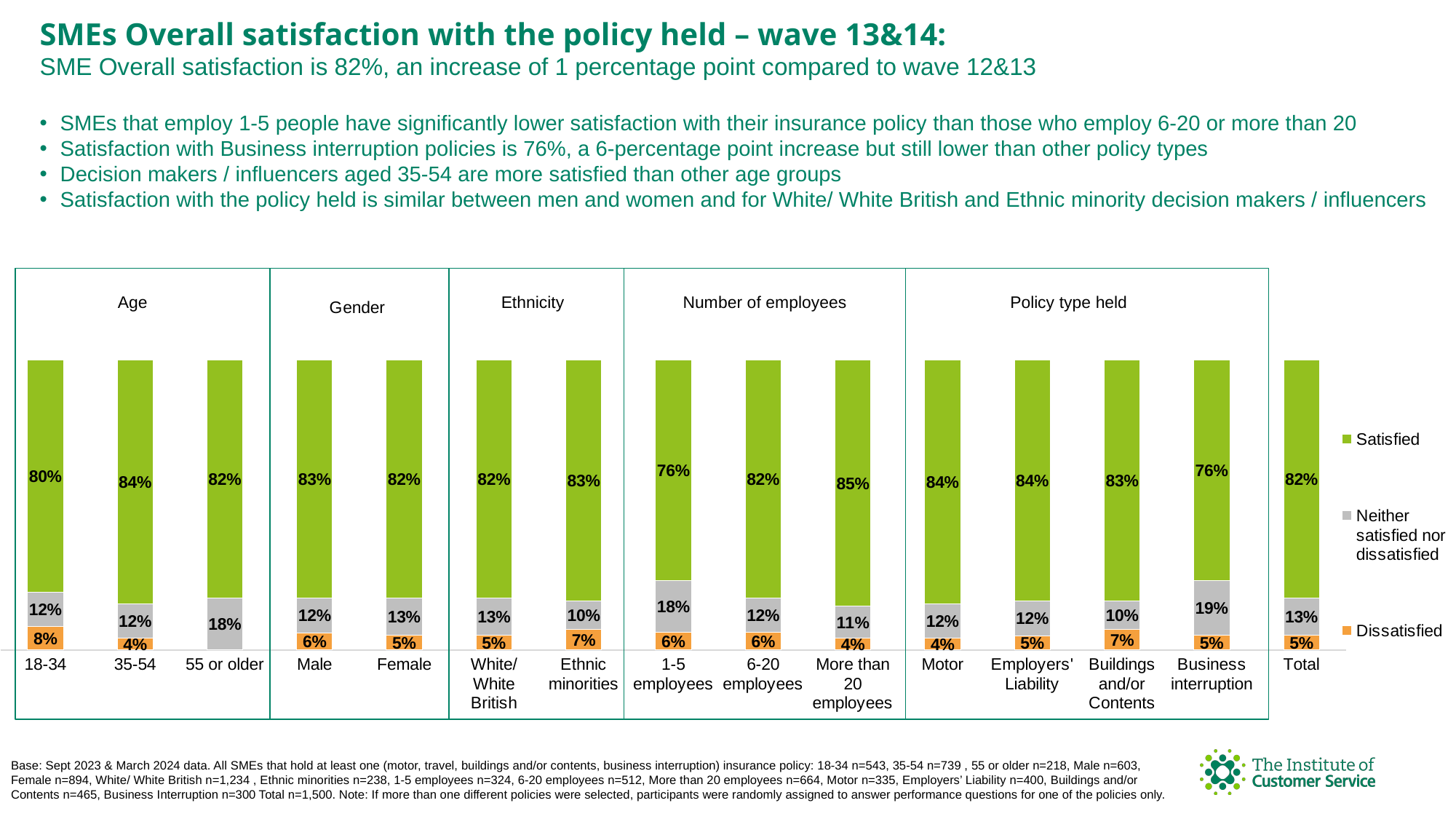
Which category has the highest Dissatisfied value? 18-34 What is the Dissatisfied value for Buildings and/or Contents? 7% What is the Dissatisfied value for the 18-34 age group? 8% Which category has the highest Satisfied value? More than 20 employees How many series does the legend list? 3 What kind of chart is shown on the slide? Stacked bar chart Which has a higher Satisfied value, Motor or Business interruption? Motor What is the Neither satisfied nor dissatisfied value for Business interruption? 19% Which category has the highest Neither satisfied nor dissatisfied value? Business interruption What is the Satisfied value for 1-5 employees? 76% What is the difference in Satisfied value between More than 20 employees and 1-5 employees? 9 percentage points What is the Satisfied value for the Total bar? 82%